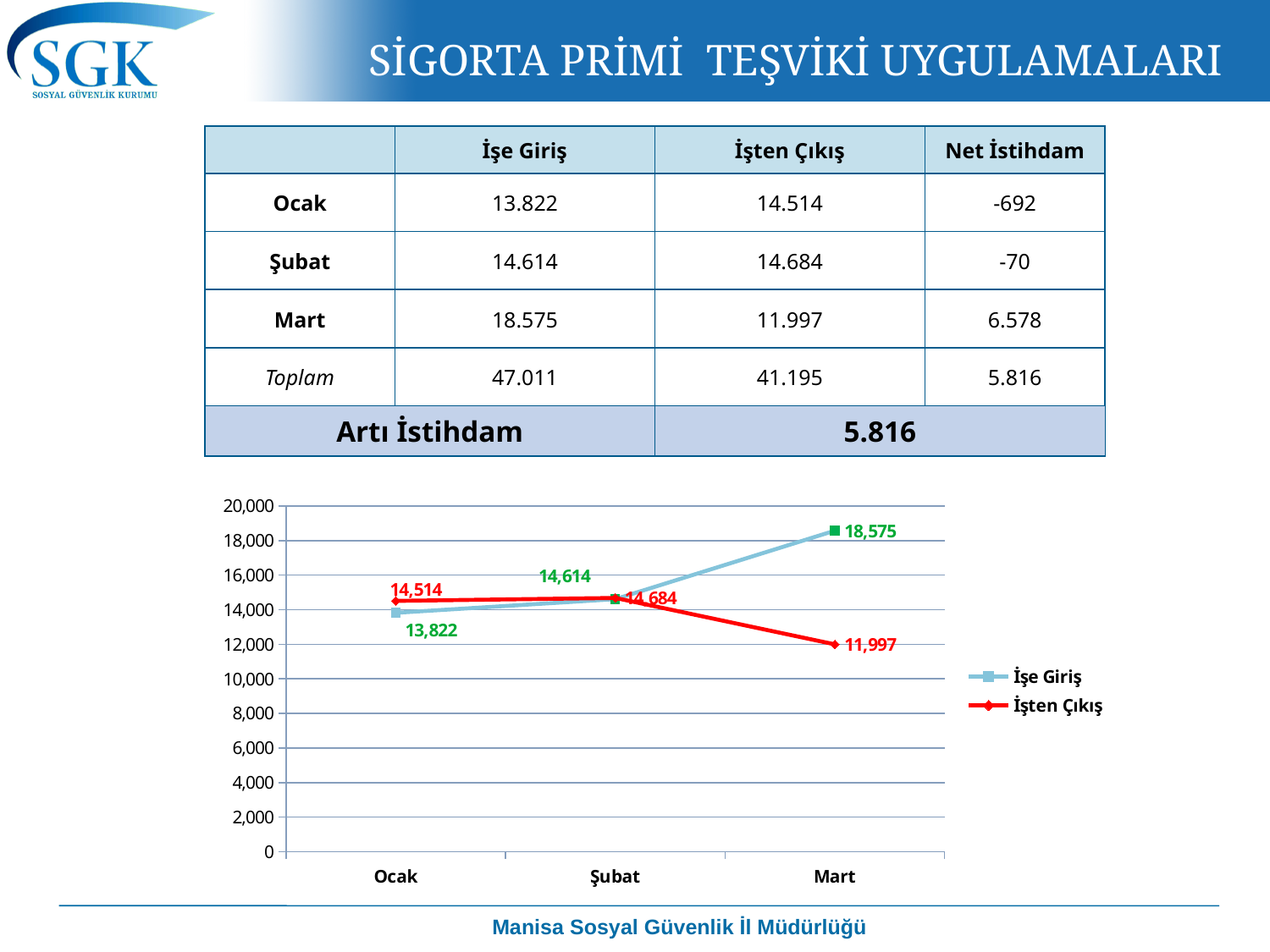
In which month is İşten Çıkış lowest in the chart? Mart What is the value of İşten Çıkış for Mart in the chart? 11,997 How many series does the chart legend list? 2 Which is larger for Ocak in the chart, İşe Giriş or İşten Çıkış? İşten Çıkış In which month is İşe Giriş highest in the chart? Mart What kind of chart is shown on the slide? line chart What is the value of İşe Giriş for Ocak in the chart? 13,822 What is the value of İşe Giriş for Mart in the chart? 18,575 What is the value of İşten Çıkış for Ocak in the chart? 14,514 Does the İşe Giriş series rise or fall from Ocak to Mart in the chart? rise What is the difference between İşe Giriş and İşten Çıkış for Mart in the chart? 6,578 How many categories are shown on the x axis of the chart? 3